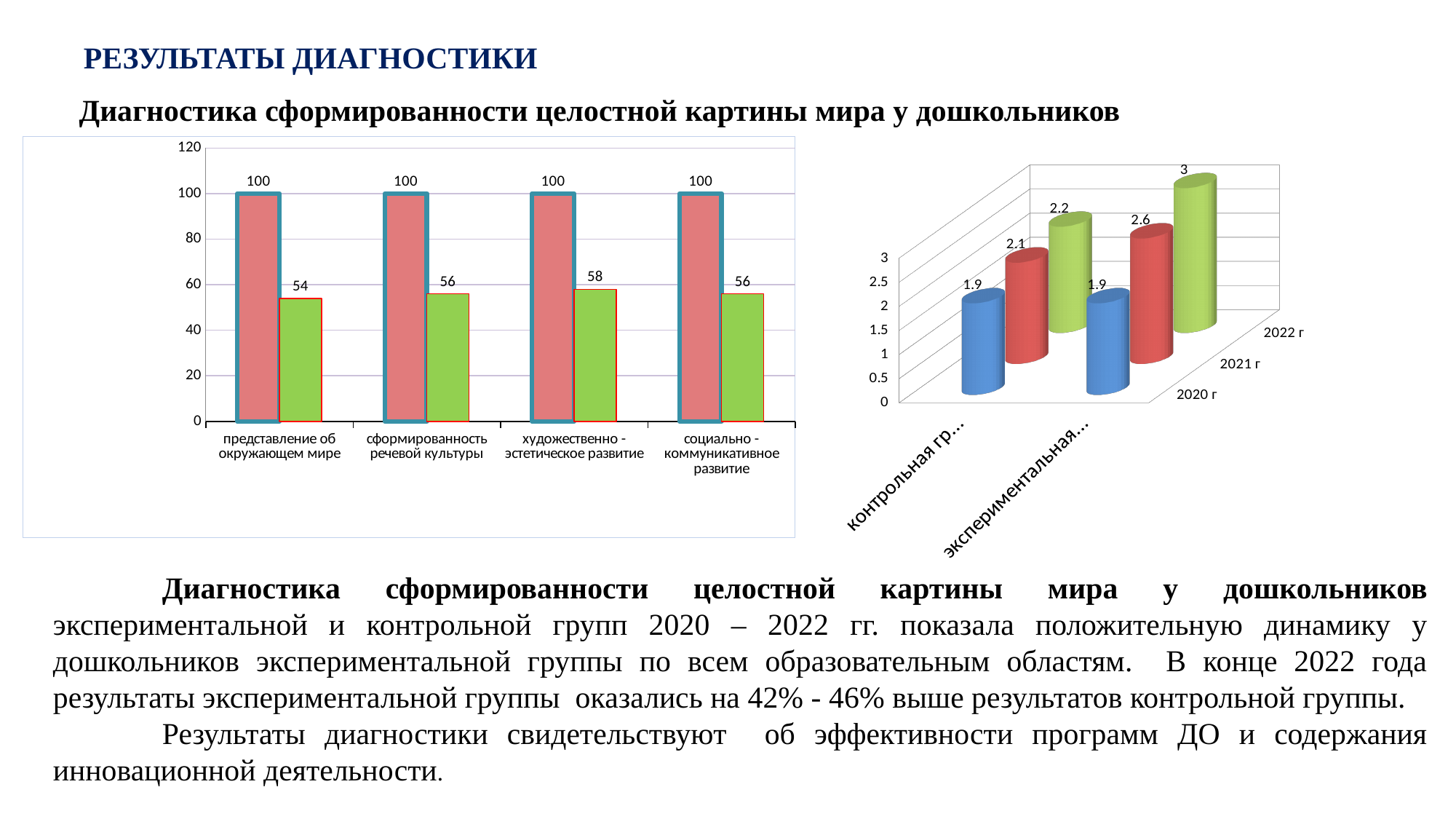
In the left chart, what is the value of the green bar for 'художественно - эстетическое развитие'? 58 In the left chart, what is the value of the red bar for 'сформированность речевой культуры'? 100 In the right chart, how many series (years) are shown? 3 In the left chart, what is the value of the green bar for 'представление об окружающем мире'? 54 In the left chart, which category has the lowest green bar? представление об окружающем мире How many categories are shown on the x axis of the left chart? 4 In the right chart, do the values for the экспериментальная group rise or fall from 2020 г to 2022 г? rise In the left chart, which category has the highest green bar? художественно - эстетическое развитие In the right chart, what is the value for the контрольная group in 2021 г? 2.1 What type of chart is the left chart? bar chart In the left chart, what is the difference between the red and green bars for 'социально - коммуникативное развитие'? 44 In the right chart, what is the value for the экспериментальная group in 2022 г? 3